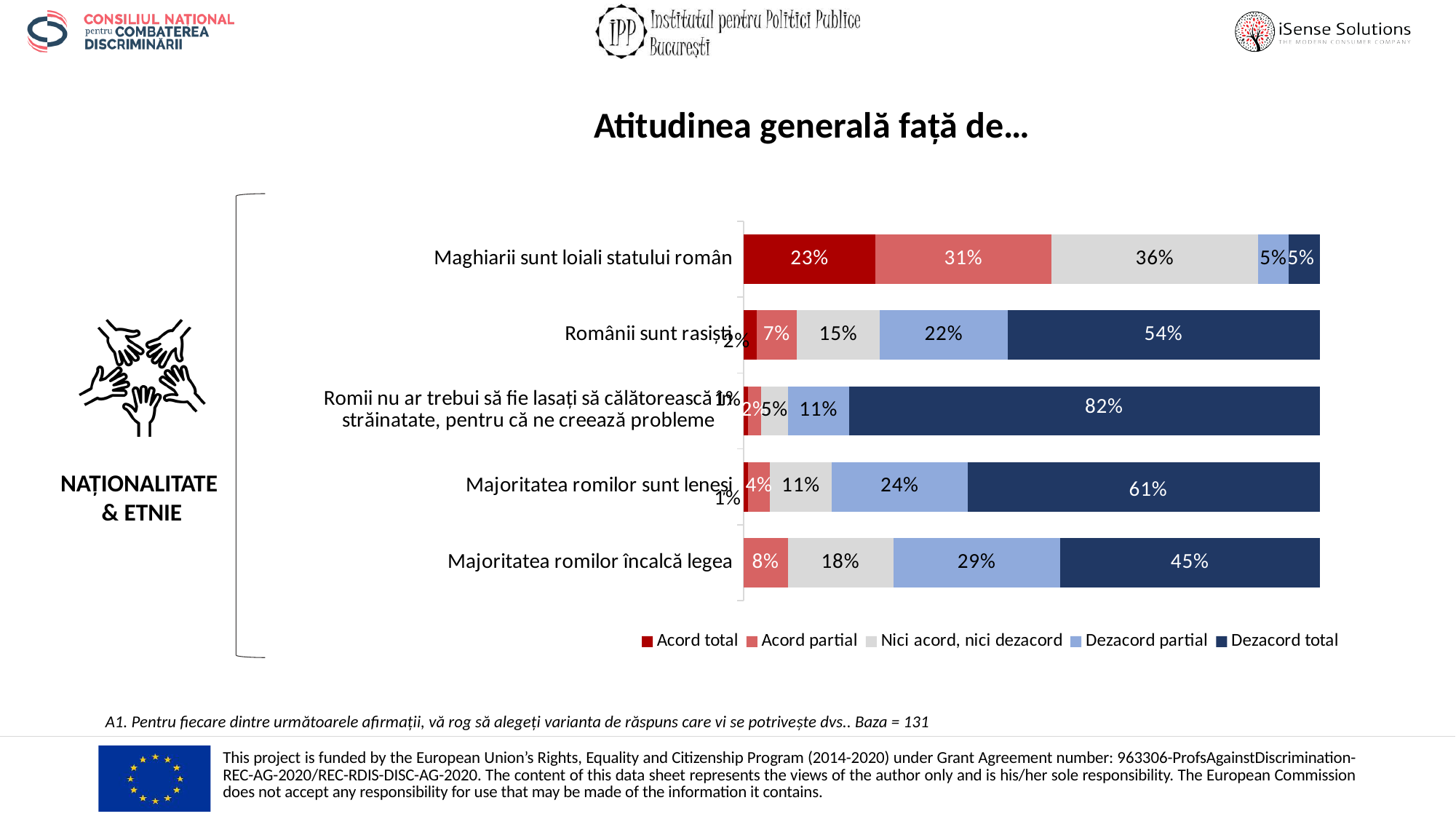
What type of chart is shown on the slide? stacked bar chart What is the 'Dezacord total' value for 'Romii nu ar trebui să fie lasați să călătorească în străinatate, pentru că ne creează probleme'? 82% Which is larger: the 'Dezacord partial' value for 'Românii sunt rasiști' or for 'Majoritatea romilor sunt leneși'? Majoritatea romilor sunt leneși What is the title of the chart? Atitudinea generală față de... What is the 'Nici acord, nici dezacord' value for 'Maghiarii sunt loiali statului român'? 36% What is the difference between the 'Dezacord total' values for 'Majoritatea romilor sunt leneși' and 'Majoritatea romilor încalcă legea'? 16% How many statements (categories) are plotted in the chart? 5 What is the 'Dezacord partial' value for 'Majoritatea romilor încalcă legea'? 29% How many series does the legend list? 5 Which statement has the highest 'Acord total' value? Maghiarii sunt loiali statului român Which statement has the highest 'Dezacord total' value? Romii nu ar trebui să fie lasați să călătorească în străinatate, pentru că ne creează probleme What is the 'Acord partial' value for 'Românii sunt rasiști'? 7%